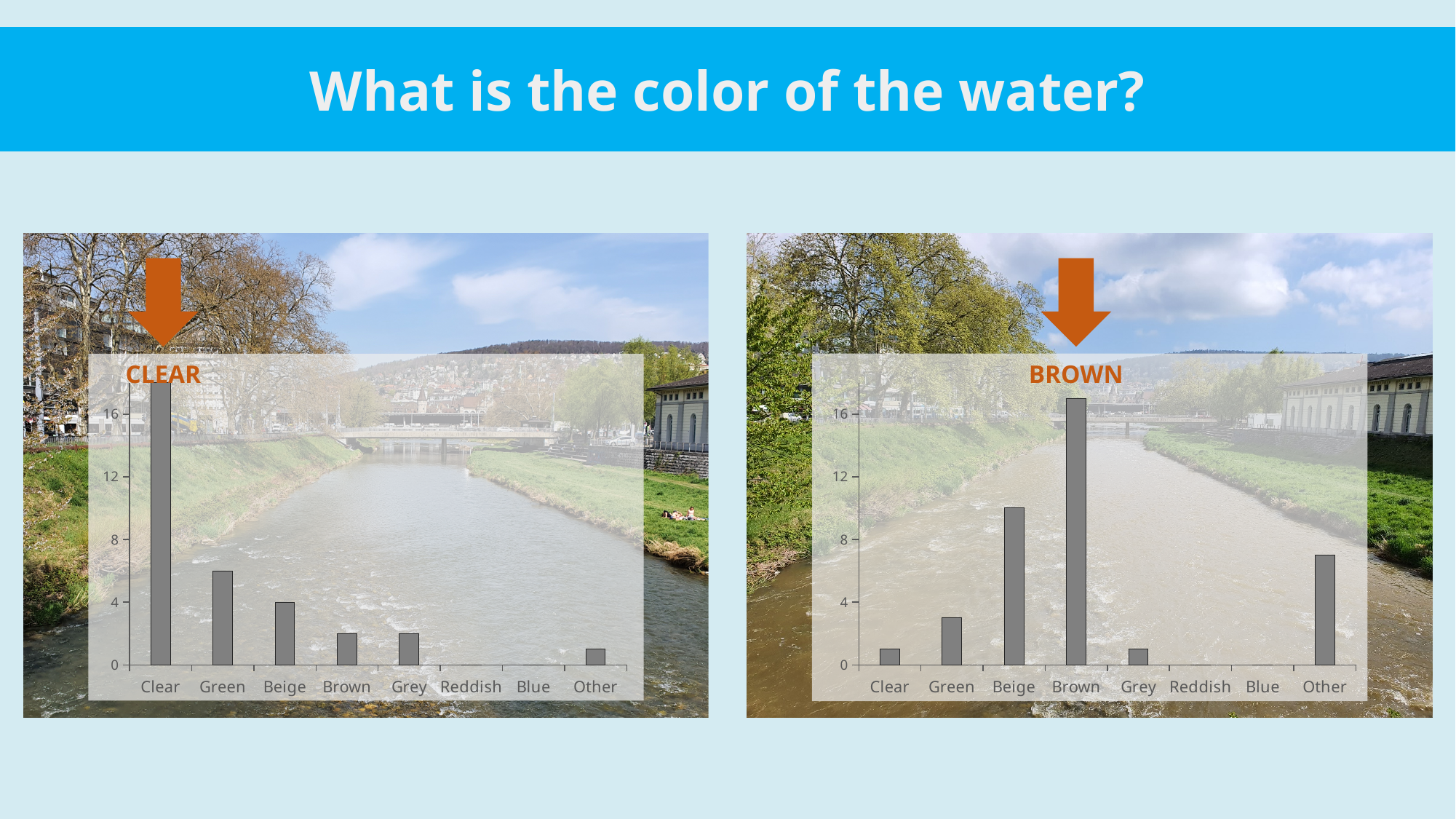
On the right chart, which category has the highest bar? Brown On the left chart, which category has the highest bar? Clear How many categories are shown on the x axis of the left chart? 8 On the right chart, is the value for Beige greater or less than 8? greater On the left chart, is the value for Green greater or less than 8? less On the left chart, which is larger, Green or Beige? Green On the right chart, which is larger, Beige or Other? Beige On the left chart, what is the value for Beige? 4 What kind of chart is the right chart? bar chart On the left chart, is the value for Clear greater or less than 16? greater On the right chart, what is the value for Reddish? 0